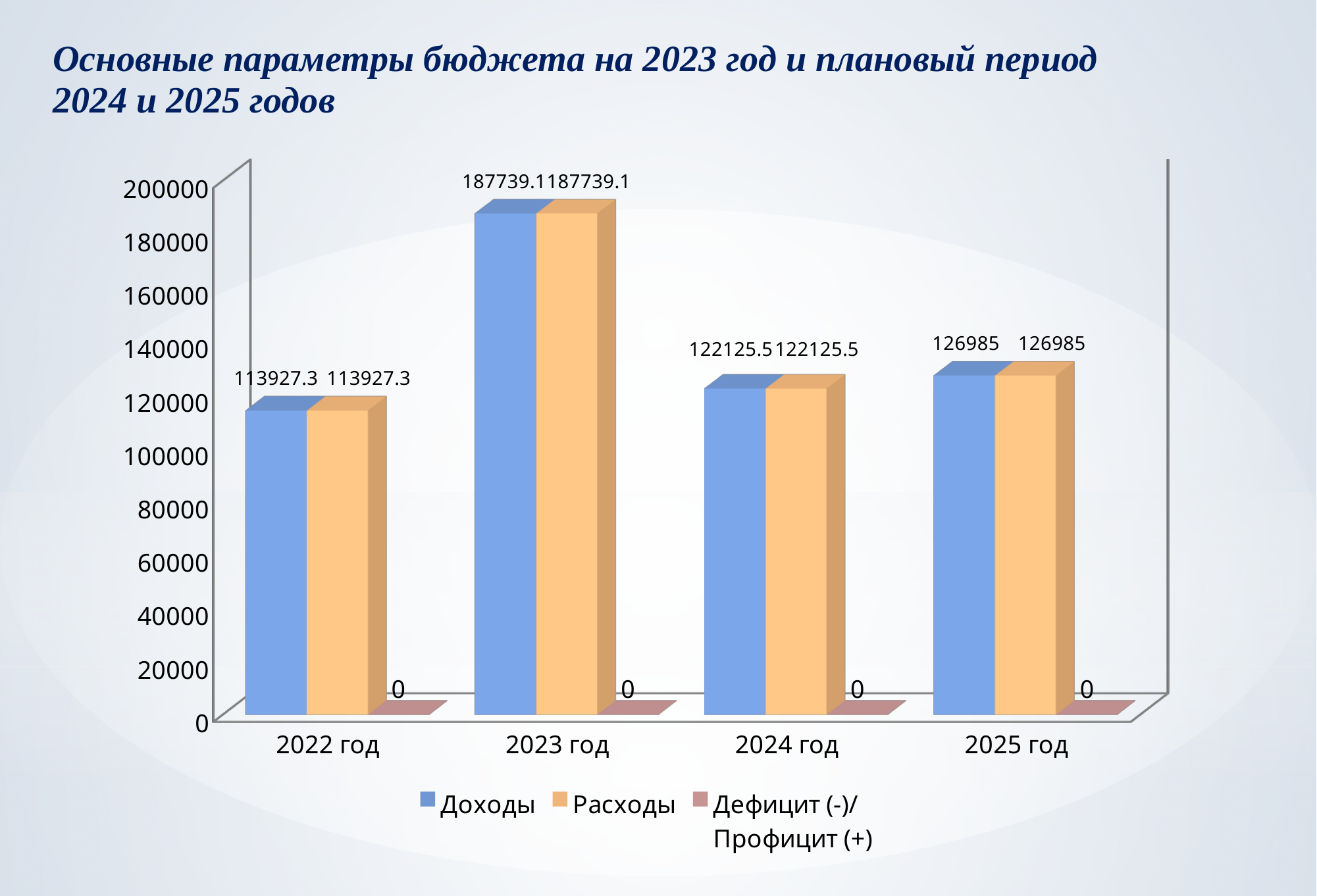
How many years are shown on the x axis? 4 Which is larger: Расходы for 2025 год or Расходы for 2024 год? 2025 год Which colour represents the Расходы series in the legend? Orange Which year has the highest value of Доходы? 2023 год What is the value of Доходы for 2025 год? 126985 How many series does the legend list? 3 What is the value of Доходы for 2023 год? 187739.1 Which year has the lowest value of Расходы? 2022 год What is the difference between Доходы for 2023 год and Доходы for 2024 год? 65613.6 What kind of chart is shown on the slide? Bar chart What is the value of Дефицит (-)/Профицит (+) for 2024 год? 0 What is the value of Расходы for 2022 год? 113927.3